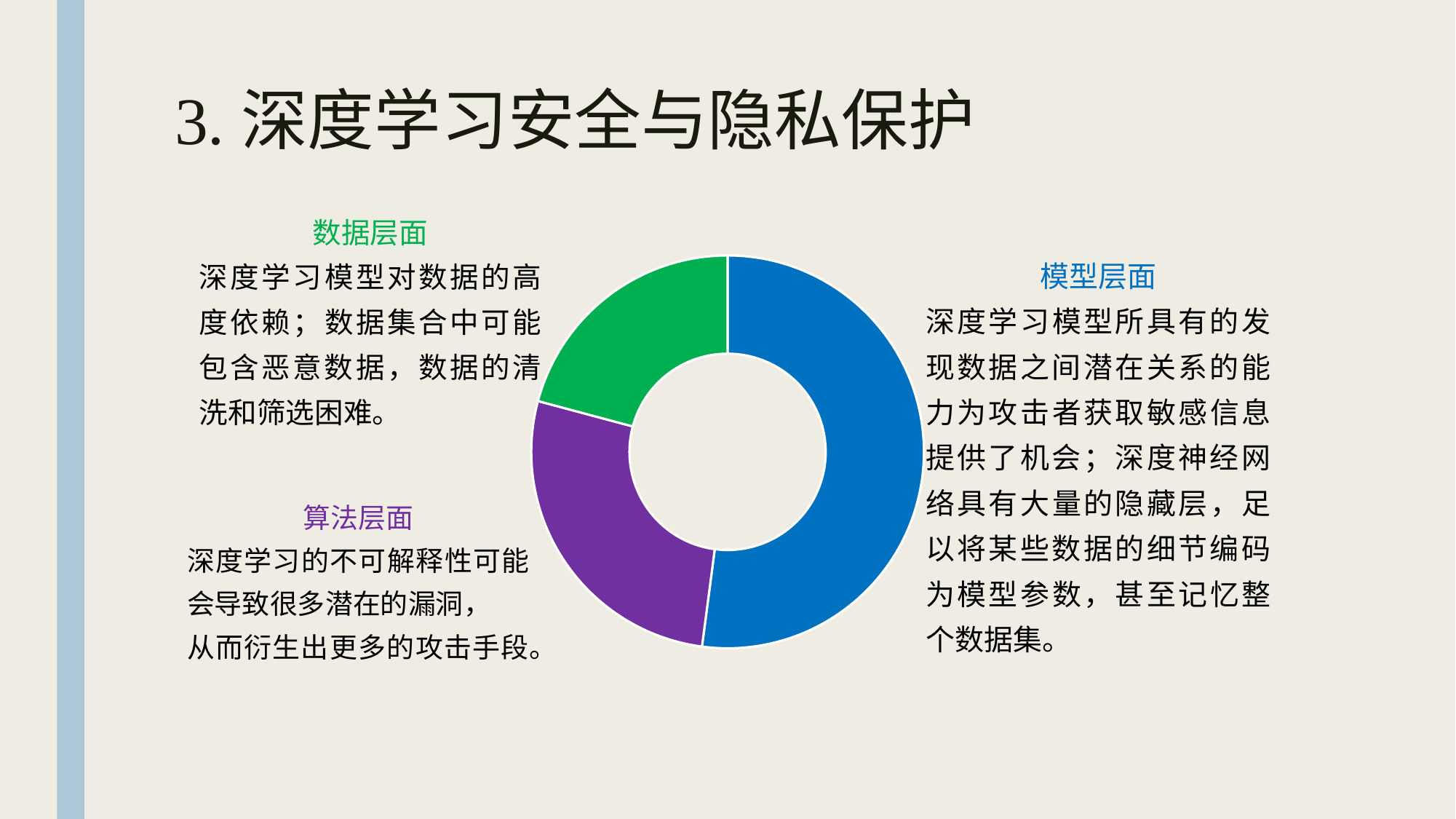
Which segment is larger in the doughnut chart, 算法层面 or 数据层面? 算法层面 What colour is the 模型层面 segment of the doughnut chart? blue Which segment is larger in the doughnut chart, 模型层面 or 算法层面? 模型层面 Which segment of the doughnut chart is the largest? 模型层面 Which category does the green segment of the doughnut chart represent? 数据层面 How many segments does the doughnut chart have? 3 What kind of chart is shown on the slide? doughnut chart Which segment of the doughnut chart is the smallest? 数据层面